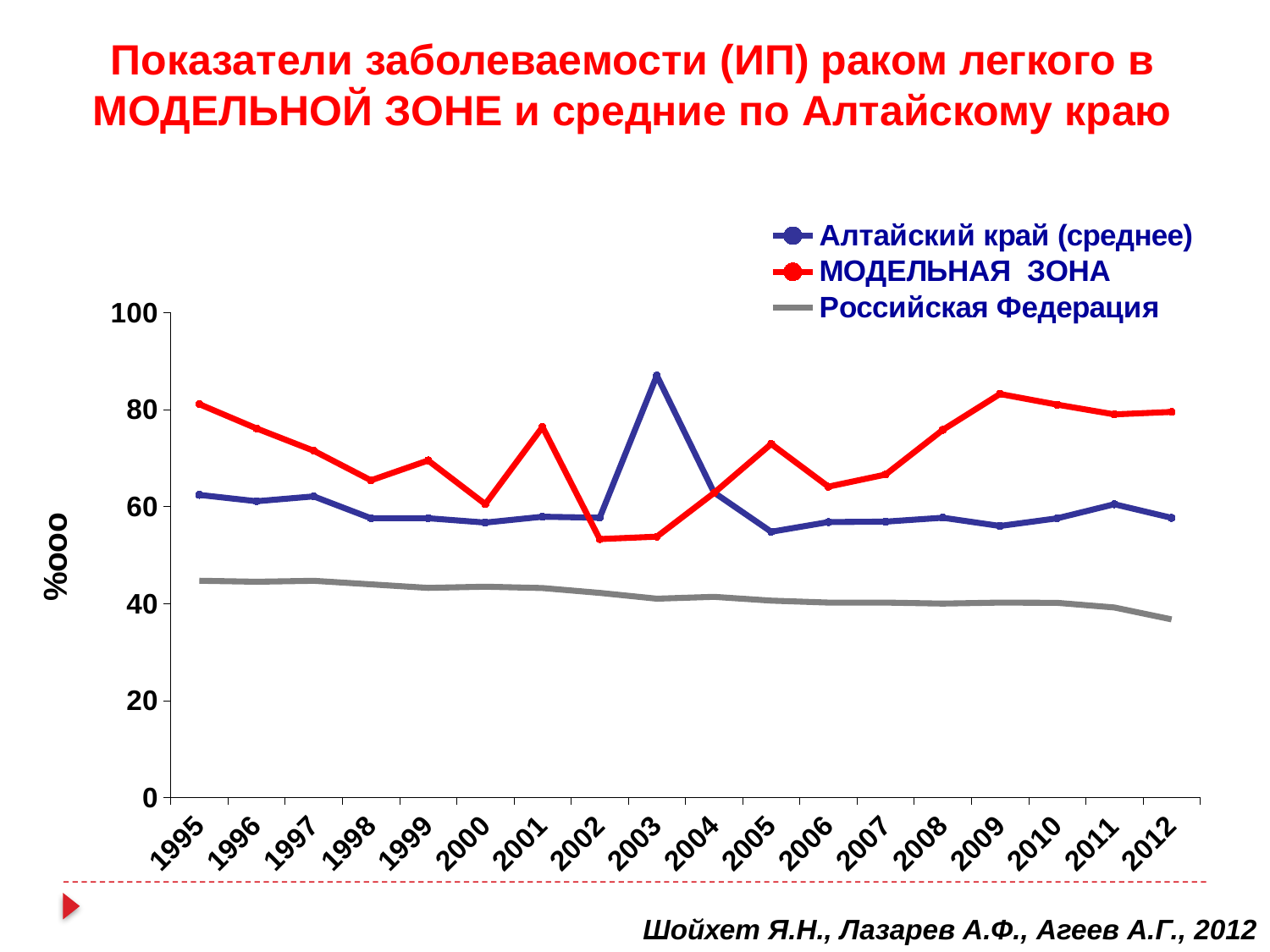
What kind of chart is shown on the slide? line chart What is the label on the y axis? %ooo Is the value for Российская Федерация in 1995 greater or less than 40? greater Which series is drawn in red? МОДЕЛЬНАЯ ЗОНА Does the Российская Федерация series rise or fall from 1995 to 2012? fall In 2003, which series has the larger value: Алтайский край (среднее) or МОДЕЛЬНАЯ ЗОНА? Алтайский край (среднее) Is the value for МОДЕЛЬНАЯ ЗОНА in 2002 greater or less than 60? less In which year does the Алтайский край (среднее) series reach its highest value? 2003 Is the value for Алтайский край (среднее) in 2003 greater or less than 80? greater How many years are shown along the x axis? 18 In 1995, which series has the larger value: МОДЕЛЬНАЯ ЗОНА or Алтайский край (среднее)? МОДЕЛЬНАЯ ЗОНА How many series does the legend list? 3